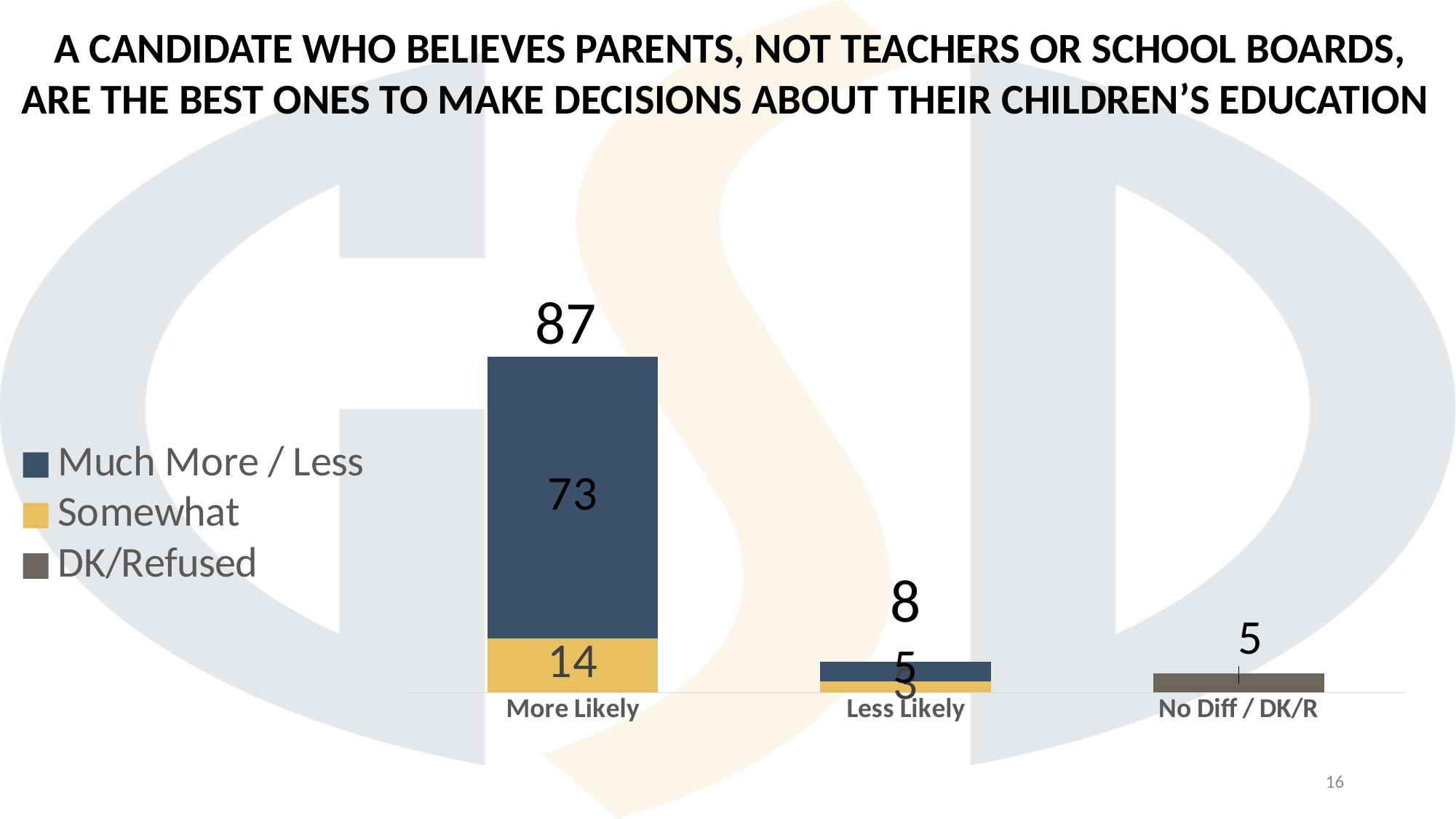
How many categories are shown on the x axis? 3 Which category has the highest total? More Likely What is the Much More / Less value for Less Likely? 5 What is the Somewhat value for Less Likely? 3 What is the total value shown above the Less Likely bar? 8 What is the total value shown above the More Likely bar? 87 What is the value for No Diff / DK/R? 5 What is the difference between the More Likely total and the Less Likely total? 79 What kind of chart is shown on the slide? Stacked bar chart What is the Somewhat value for More Likely? 14 What is the Much More / Less value for More Likely? 73 How many series does the legend list? 3